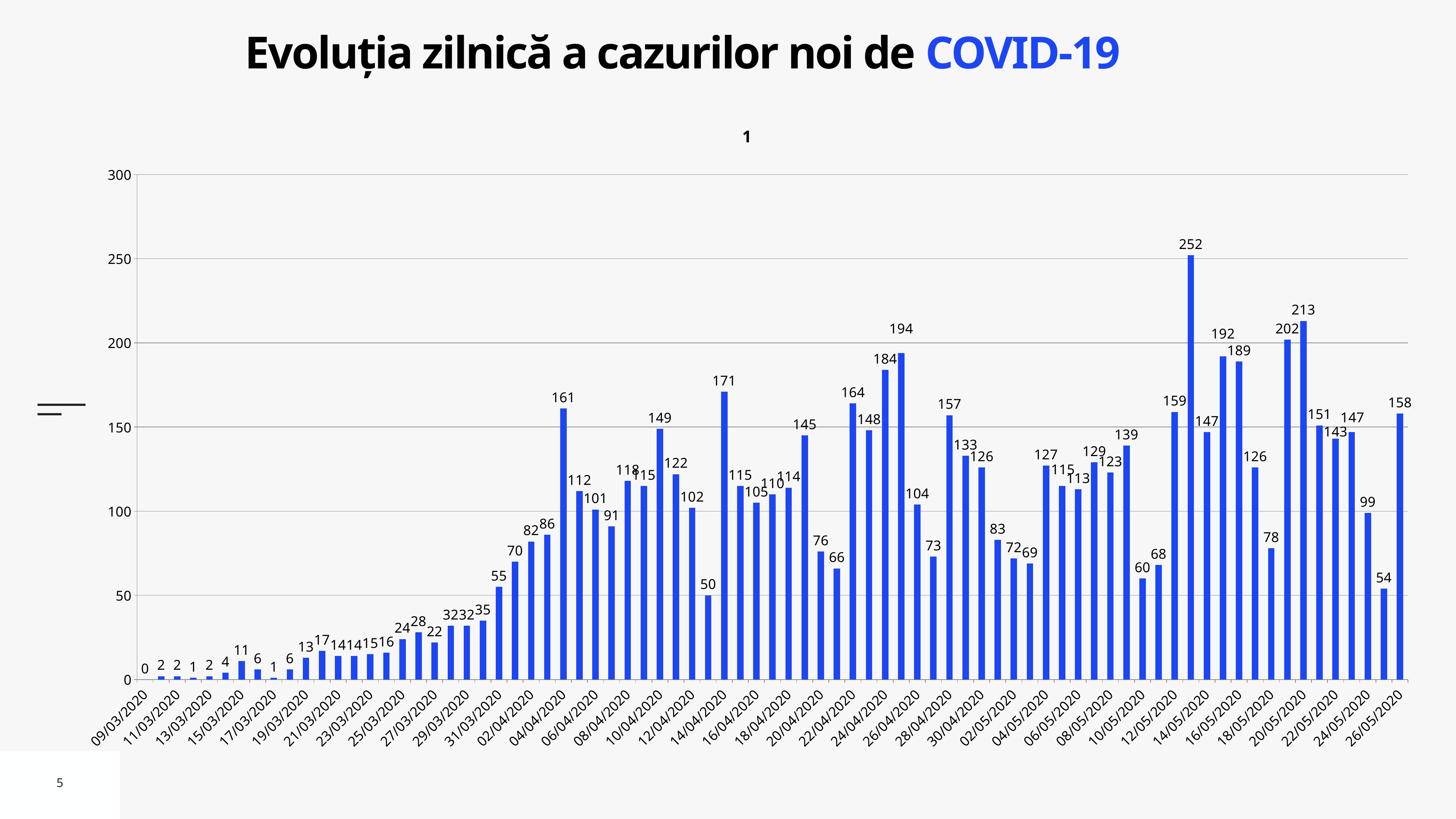
What kind of chart is shown on the slide? bar chart Is the value for 12/05/2020 greater or less than 150? greater What is the title of the slide? Evoluția zilnică a cazurilor noi de COVID-19 Do the values generally rise or fall from 09/03/2020 to 31/03/2020? rise What is the difference between the values for 20/05/2020 and 26/05/2020? 55 What is the value for 26/05/2020? 158 What is the value for 10/05/2020? 60 Which is larger, the value for 24/04/2020 or the value for 16/05/2020? 16/05/2020 Which date has the lowest value on the chart? 09/03/2020 What is the highest daily value shown on the chart? 252 What is the value for 14/04/2020? 171 What is the value for 04/04/2020? 161